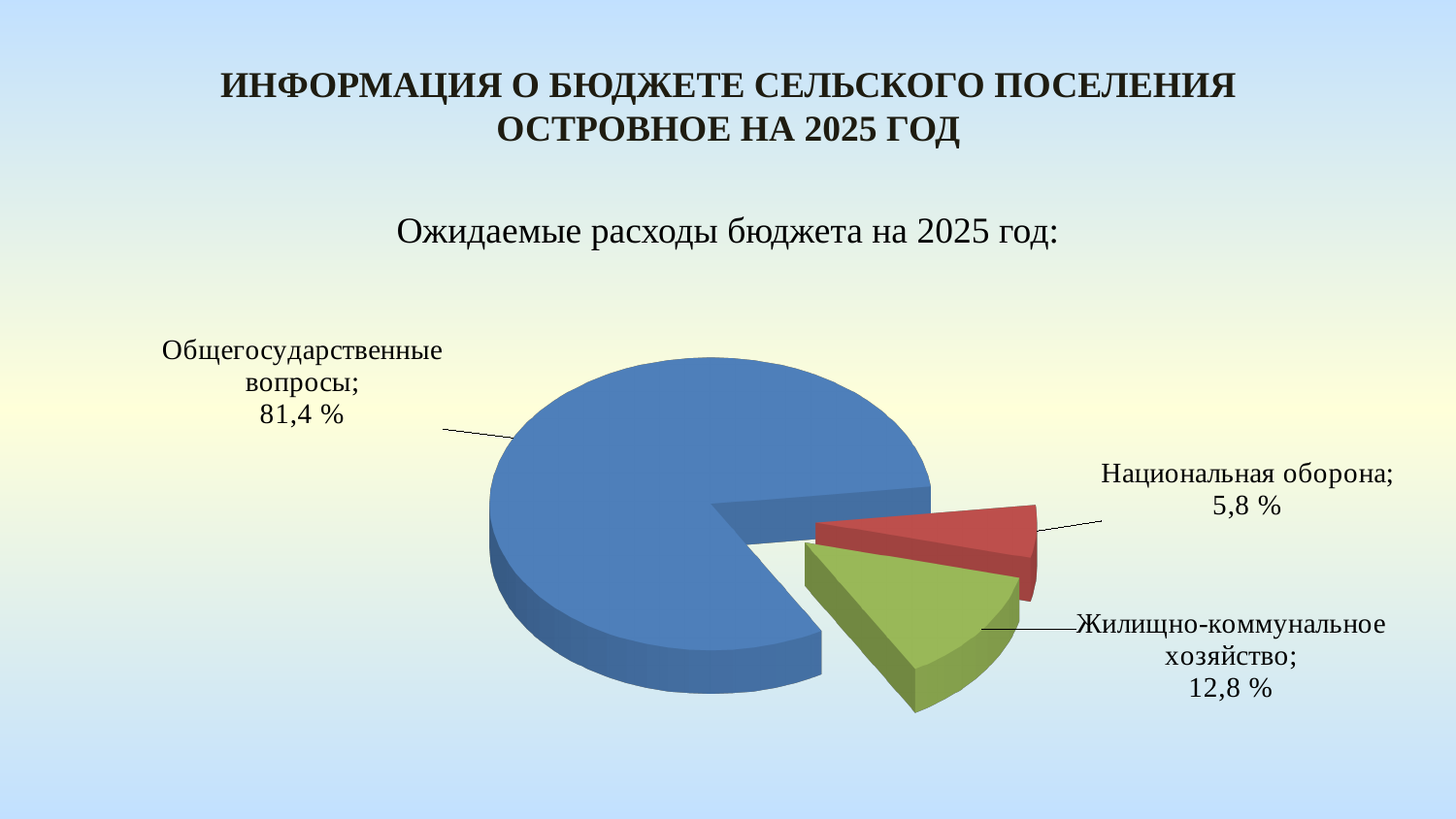
What colour is the slice for Общегосударственные вопросы? Blue What is the subtitle above the pie chart? Ожидаемые расходы бюджета на 2025 год: Which category has the largest share of the expected 2025 budget expenses? Общегосударственные вопросы Which is larger: the share for Жилищно-коммунальное хозяйство or the share for Национальная оборона? Жилищно-коммунальное хозяйство What is the difference in percentage points between Жилищно-коммунальное хозяйство and Национальная оборона? 7,0 Which category has the smallest share of the expected 2025 budget expenses? Национальная оборона How many categories are shown in the pie chart? 3 What share of the expected 2025 budget expenses goes to Национальная оборона? 5,8 % What share of the expected 2025 budget expenses goes to Жилищно-коммунальное хозяйство? 12,8 % What share of the expected 2025 budget expenses goes to Общегосударственные вопросы? 81,4 % What kind of chart is shown on the slide? Pie chart What is the difference in percentage points between Общегосударственные вопросы and Жилищно-коммунальное хозяйство? 68,6